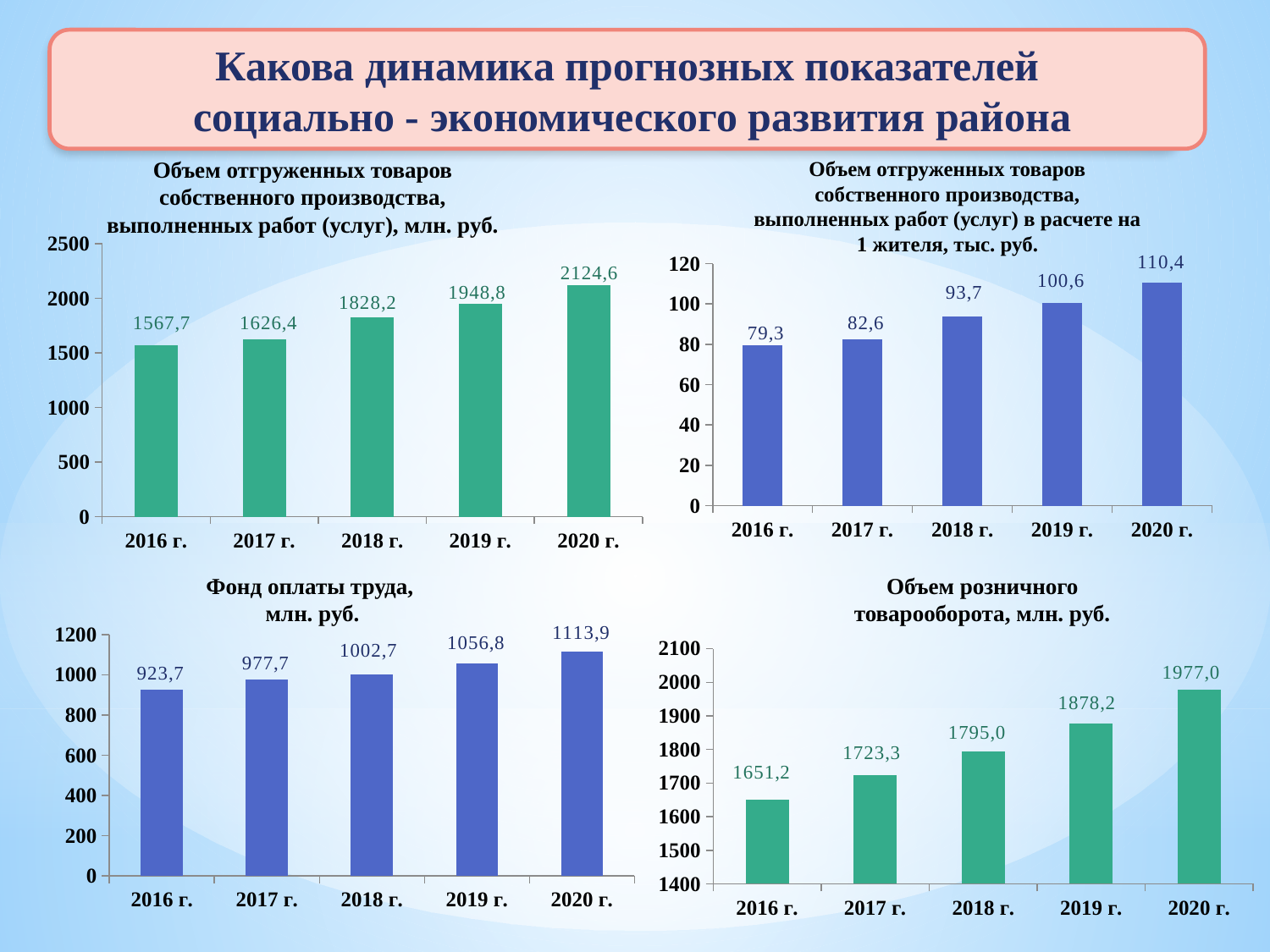
What type of chart is the top-right chart (в расчете на 1 жителя, тыс. руб.)? bar chart In the top-right chart (в расчете на 1 жителя, тыс. руб.), which is larger: the value for 2017 г. or the value for 2019 г.? 2019 г. In the top-left chart (Объем отгруженных товаров ... млн. руб.), which year has the lowest value? 2016 г. In the bottom-right chart (Объем розничного товарооборота, млн. руб.), what is the value for 2016 г.? 1651,2 In the bottom-left chart (Фонд оплаты труда, млн. руб.), which year has the highest value? 2020 г. In the top-right chart (в расчете на 1 жителя, тыс. руб.), what is the value for 2018 г.? 93,7 In the bottom-right chart (Объем розничного товарооборота, млн. руб.), what is the difference between the values for 2020 г. and 2019 г.? 98,8 In the bottom-right chart (Объем розничного товарооборота, млн. руб.), do the values rise or fall from 2016 г. to 2020 г.? rise In the top-left chart (Объем отгруженных товаров ... млн. руб.), what is the difference between the values for 2020 г. and 2016 г.? 556,9 In the bottom-left chart (Фонд оплаты труда, млн. руб.), what is the value for 2019 г.? 1056,8 In the top-left chart (Объем отгруженных товаров ... млн. руб.), what is the value for 2020 г.? 2124,6 In the bottom-left chart (Фонд оплаты труда, млн. руб.), how many years are shown on the x axis? 5